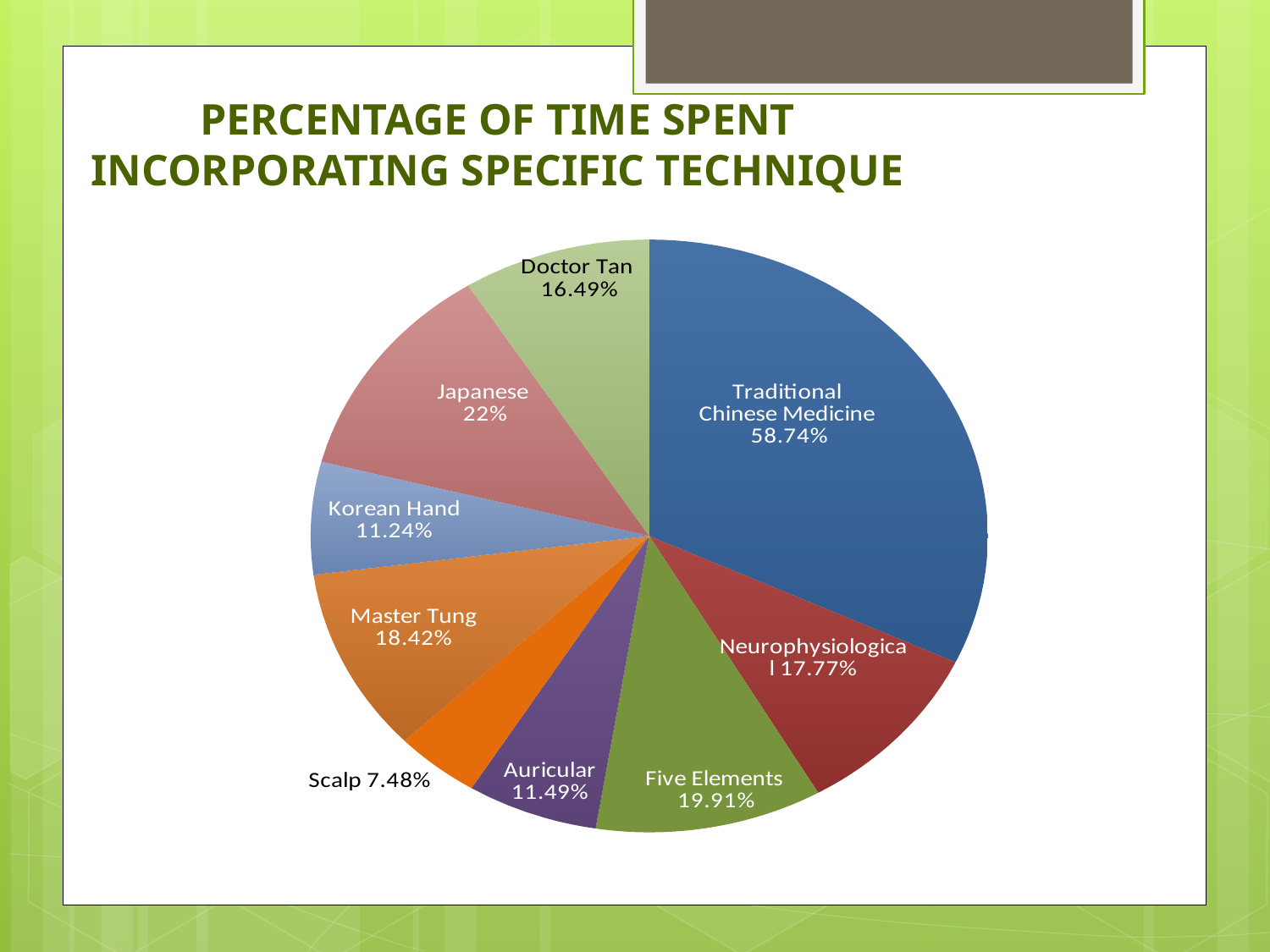
What value is shown for Scalp? 7.48% What is the title of the chart? Percentage of Time Spent Incorporating Specific Technique What value is shown for Master Tung? 18.42% What kind of chart is shown on the slide? pie chart What value is shown for Traditional Chinese Medicine? 58.74% Which has a larger value, Five Elements or Neurophysiological? Five Elements What value is shown for Five Elements? 19.91% What is the difference between the values for Japanese and Doctor Tan? 5.51% Which technique has the highest value in the chart? Traditional Chinese Medicine Which technique has the lowest value in the chart? Scalp What value is shown for Japanese? 22% How many slices does the pie chart have? 9